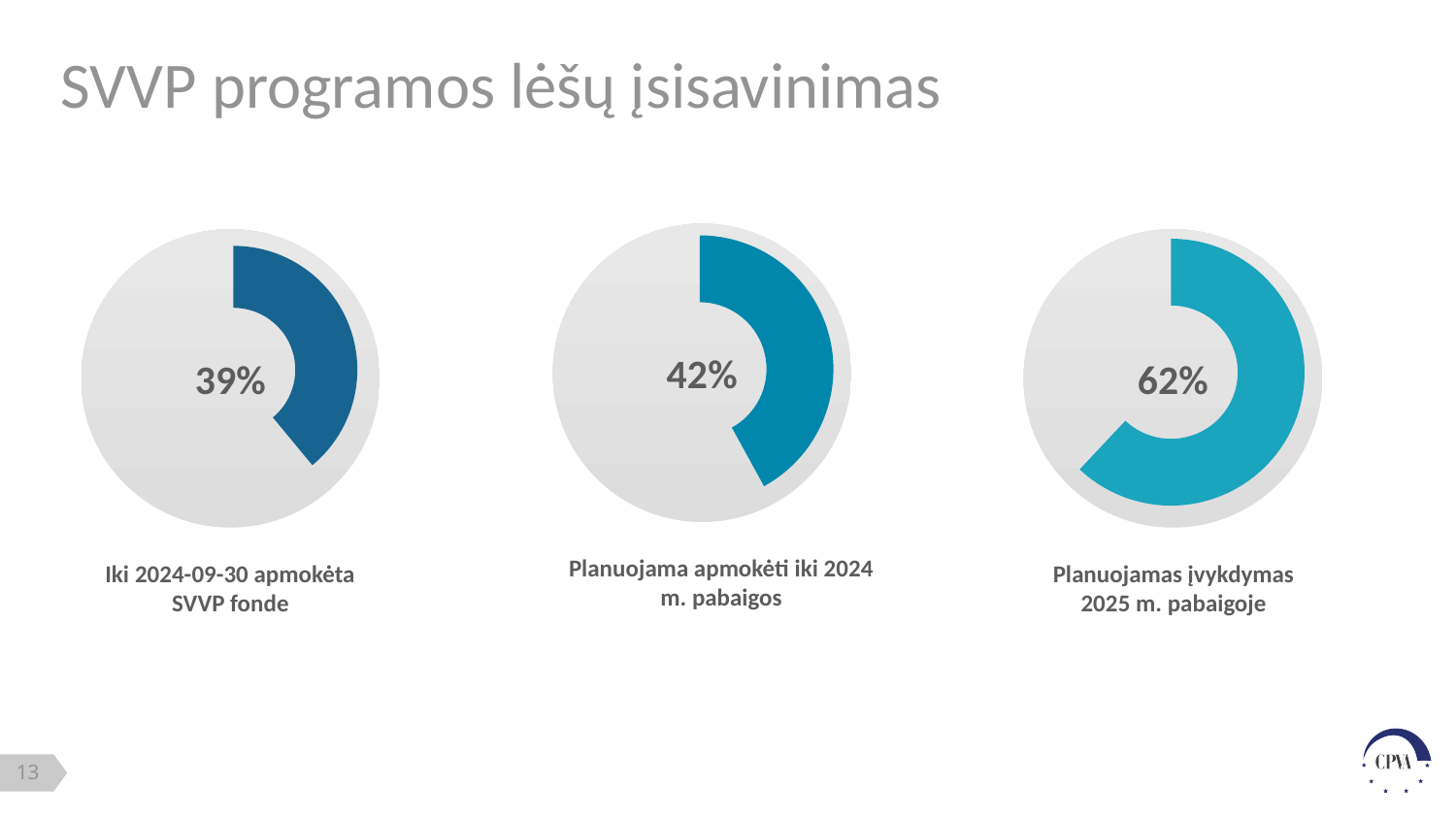
Do the percentages increase or decrease reading the charts from left to right? increase Which of the three charts shows the lowest percentage? Iki 2024-09-30 apmokėta SVVP fonde What percentage is shown in the left chart labelled 'Iki 2024-09-30 apmokėta SVVP fonde'? 39% What is the difference between the percentage in the middle chart (42%) and the percentage in the left chart (39%)? 3% What percentage is shown in the right chart labelled 'Planuojamas įvykdymas 2025 m. pabaigoje'? 62% What kind of chart is used to display the percentages on this slide? doughnut chart What is the title of the slide? SVVP programos lėšų įsisavinimas Which is larger: the percentage in the middle chart or the percentage in the right chart? the right chart (62%) What is the difference between the percentage in the right chart (62%) and the percentage in the left chart (39%)? 23% What percentage is shown in the middle chart labelled 'Planuojama apmokėti iki 2024 m. pabaigos'? 42% How many doughnut charts are shown on the slide? 3 Which of the three charts shows the highest percentage? Planuojamas įvykdymas 2025 m. pabaigoje